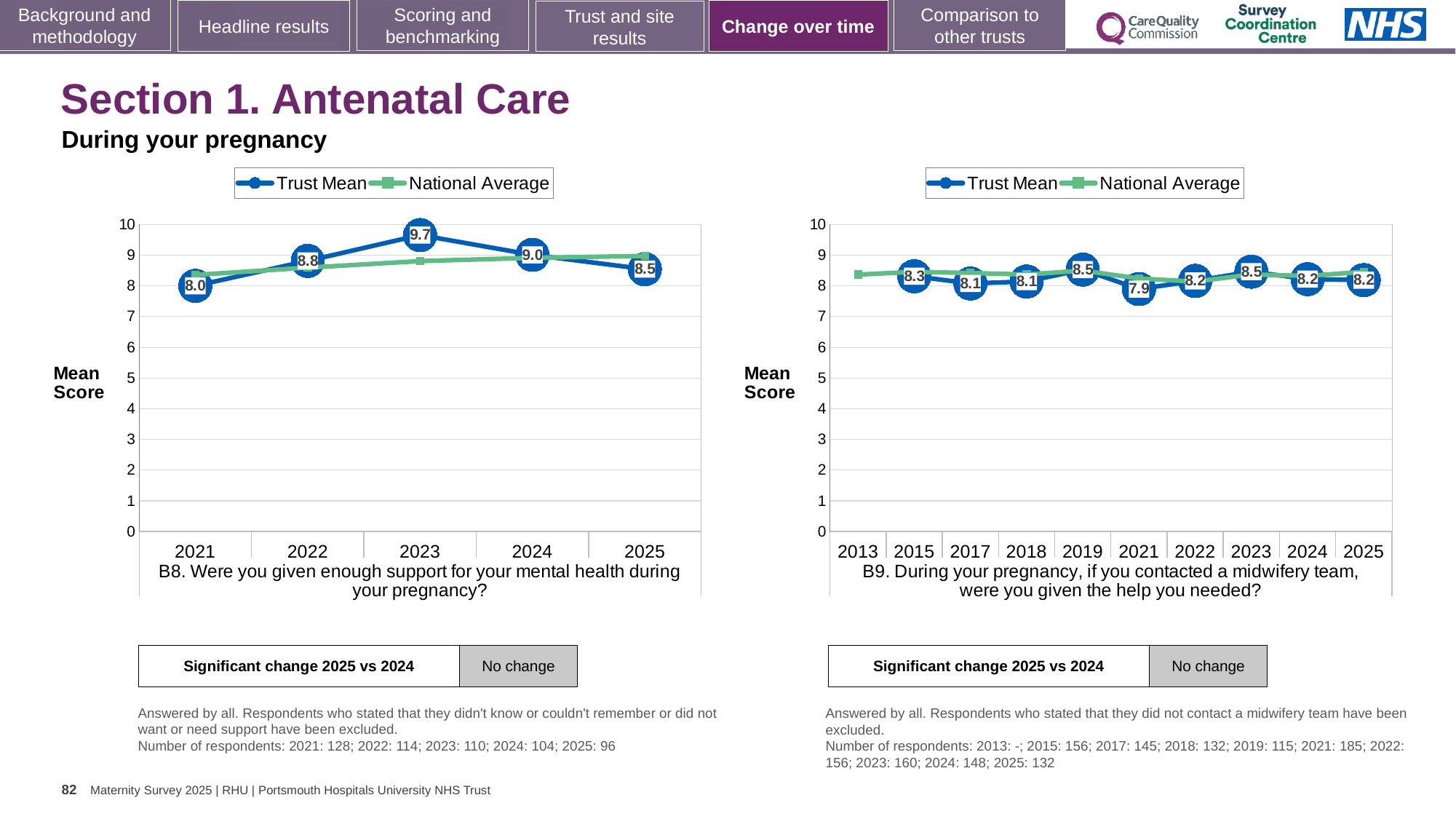
In the B8 chart on the left, what is the Trust Mean for 2021? 8.0 In the B9 chart on the right, is the Trust Mean for 2019 larger or smaller than the Trust Mean for 2021? larger In the B9 chart on the right, how many series does the legend list? 2 In the B8 chart on the left, how many years are shown on the x axis? 5 In the B8 chart on the left, what is the Trust Mean for 2023? 9.7 In the B8 chart on the left, which year has the highest Trust Mean? 2023 What kind of chart is the B8 chart on the left? line chart In the B9 chart on the right, which year has the lowest Trust Mean? 2021 In the B8 chart on the left, what is the difference between the Trust Mean for 2023 and 2025? 1.2 In the B9 chart on the right, what is the Trust Mean for 2021? 7.9 In the B8 chart on the left, which year has the lowest Trust Mean? 2021 In the B9 chart on the right, what is the Trust Mean for 2025? 8.2